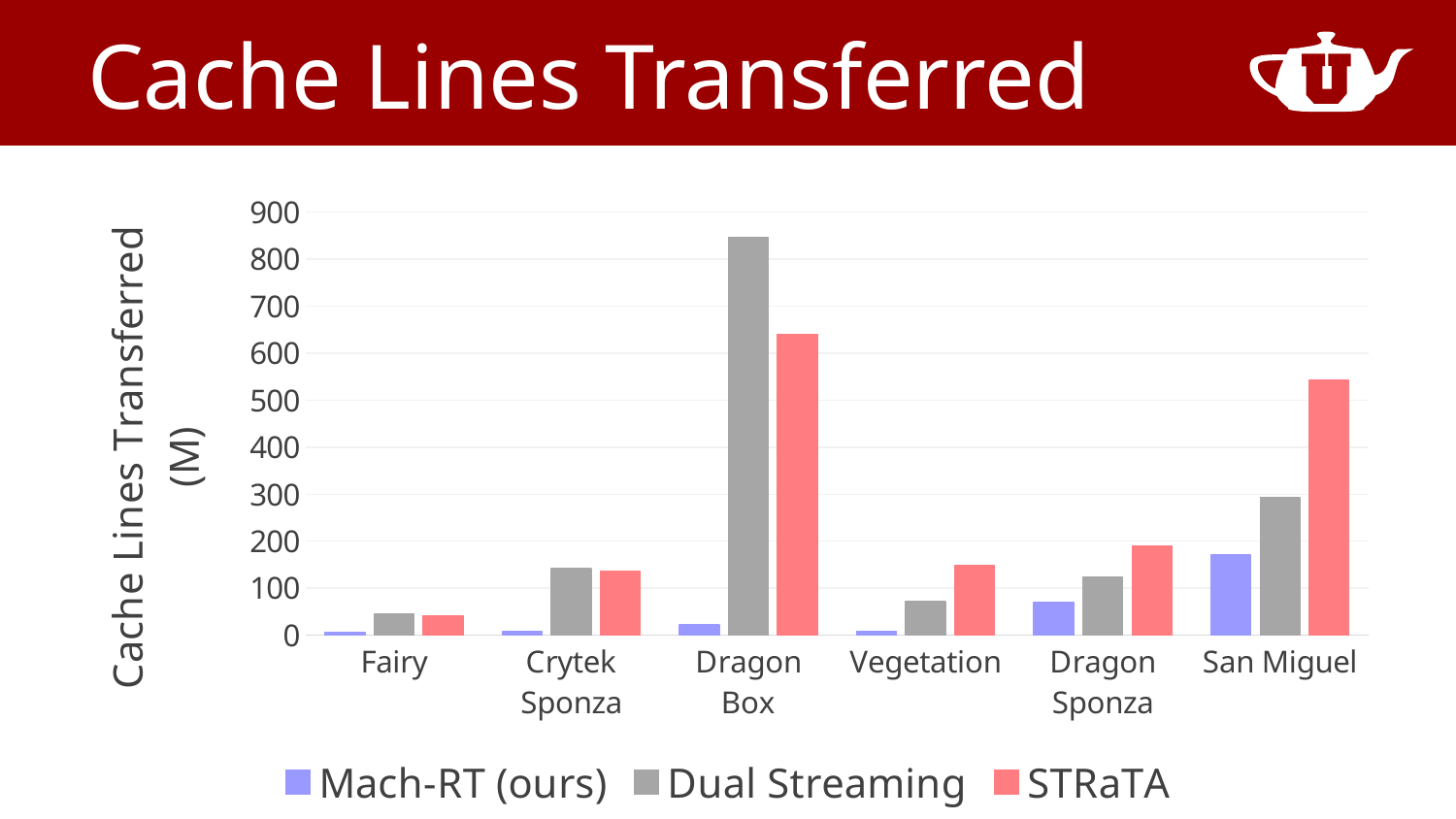
Is the STRaTA value for San Miguel greater or less than 500? greater Is the Dual Streaming value for Dragon Box greater or less than 800? greater What is the label on the y axis? Cache Lines Transferred (M) Is the Mach-RT (ours) value for San Miguel greater or less than 200? less For San Miguel, which is larger: Dual Streaming or STRaTA? STRaTA For which scene is the STRaTA bar the highest? Dragon Box What kind of chart is shown on the slide? bar chart How many scenes (categories) are shown on the x axis? 6 For Dragon Box, which is larger: Dual Streaming or STRaTA? Dual Streaming For which scene is the Mach-RT (ours) bar the highest? San Miguel For which scene is the Dual Streaming bar the highest? Dragon Box How many series does the legend list? 3